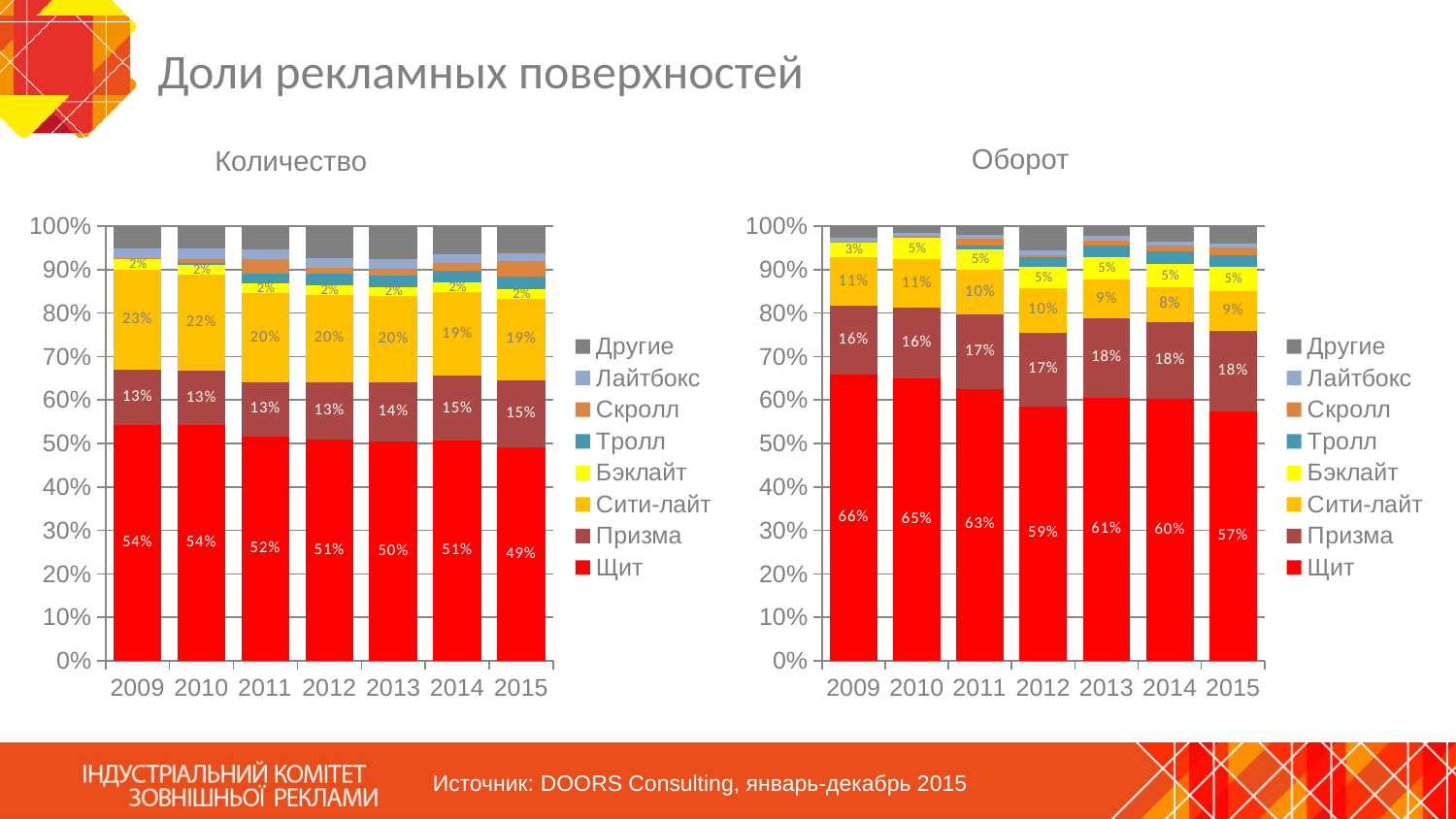
In the "Оборот" chart, what is the value for Щит in 2015? 57% In the "Количество" chart, what is the value for Сити-лайт in 2010? 22% In the "Оборот" chart, does the Призма share rise or fall from 2009 to 2015? Rise In the "Оборот" chart, what is the difference between the Щит share in 2009 and in 2015? 9% In the "Количество" chart, which is larger in 2014: Призма or Сити-лайт? Сити-лайт In the "Оборот" chart, in which year is the Щит share highest? 2009 In the "Оборот" chart, what is the value for Призма in 2013? 18% In the "Количество" chart, in which year is the Щит share lowest? 2015 What kind of chart is the "Оборот" chart? Stacked bar chart How many series does the legend of the "Оборот" chart list? 8 How many years are shown on the x axis of the "Количество" chart? 7 In the "Количество" chart, what is the value for Щит in 2009? 54%